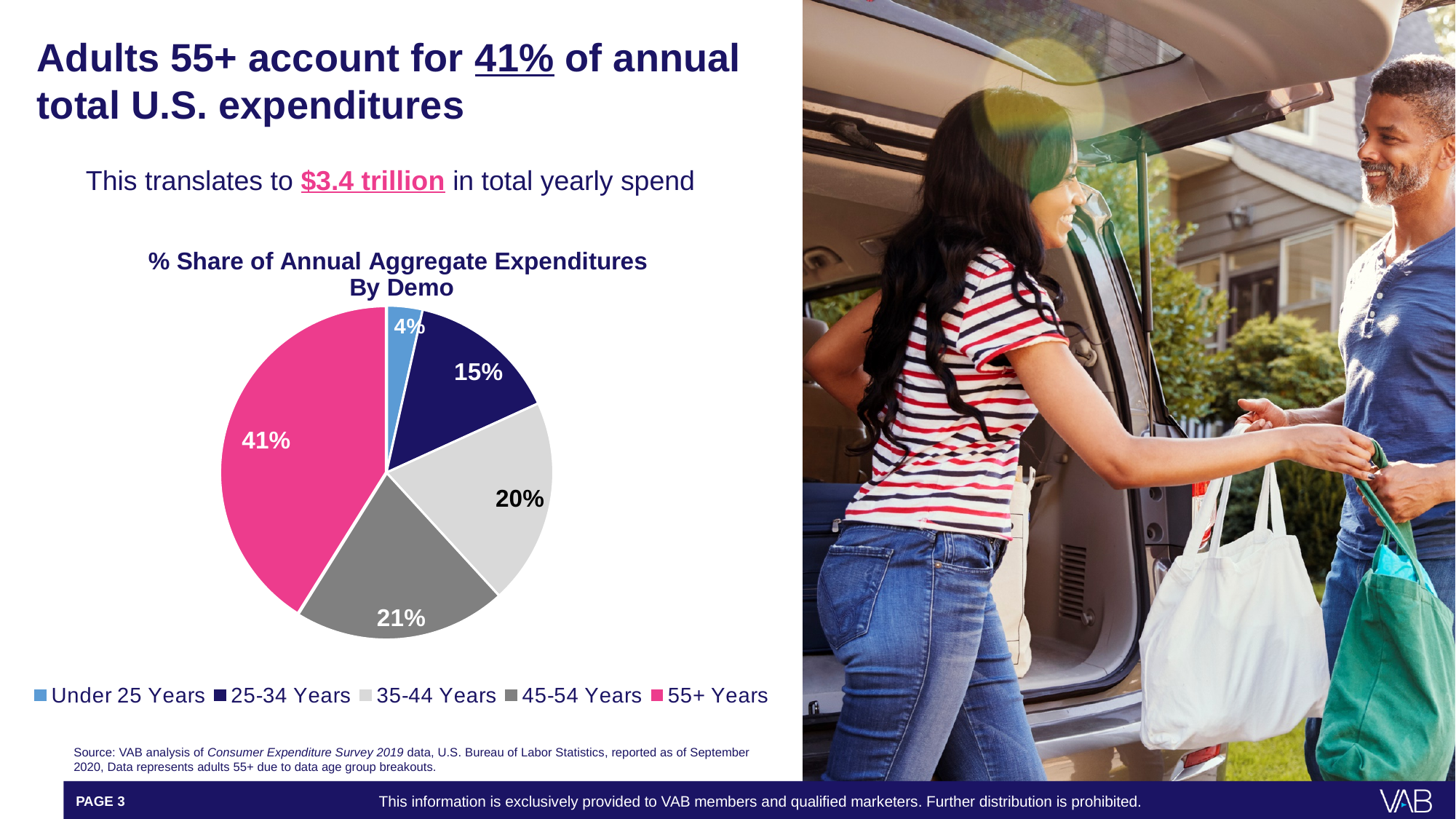
What share of annual aggregate expenditures is attributed to the Under 25 Years group? 4% What is the difference in share between the 55+ Years group and the 45-54 Years group? 20% What share of annual aggregate expenditures is attributed to the 25-34 Years group? 15% What share of annual aggregate expenditures is attributed to the 35-44 Years group? 20% What share of annual aggregate expenditures is attributed to the 55+ Years group? 41% Which demographic group has the smallest share of annual aggregate expenditures? Under 25 Years What colour represents the 55+ Years group in the pie chart? Pink What type of chart is used to show the share of annual aggregate expenditures by demo? Pie chart What is the combined share of the 35-44 Years and 45-54 Years groups? 41% How many demographic groups are shown in the pie chart? 5 Which demographic group has the largest share of annual aggregate expenditures? 55+ Years Which group has a larger share of expenditures, 25-34 Years or 45-54 Years? 45-54 Years